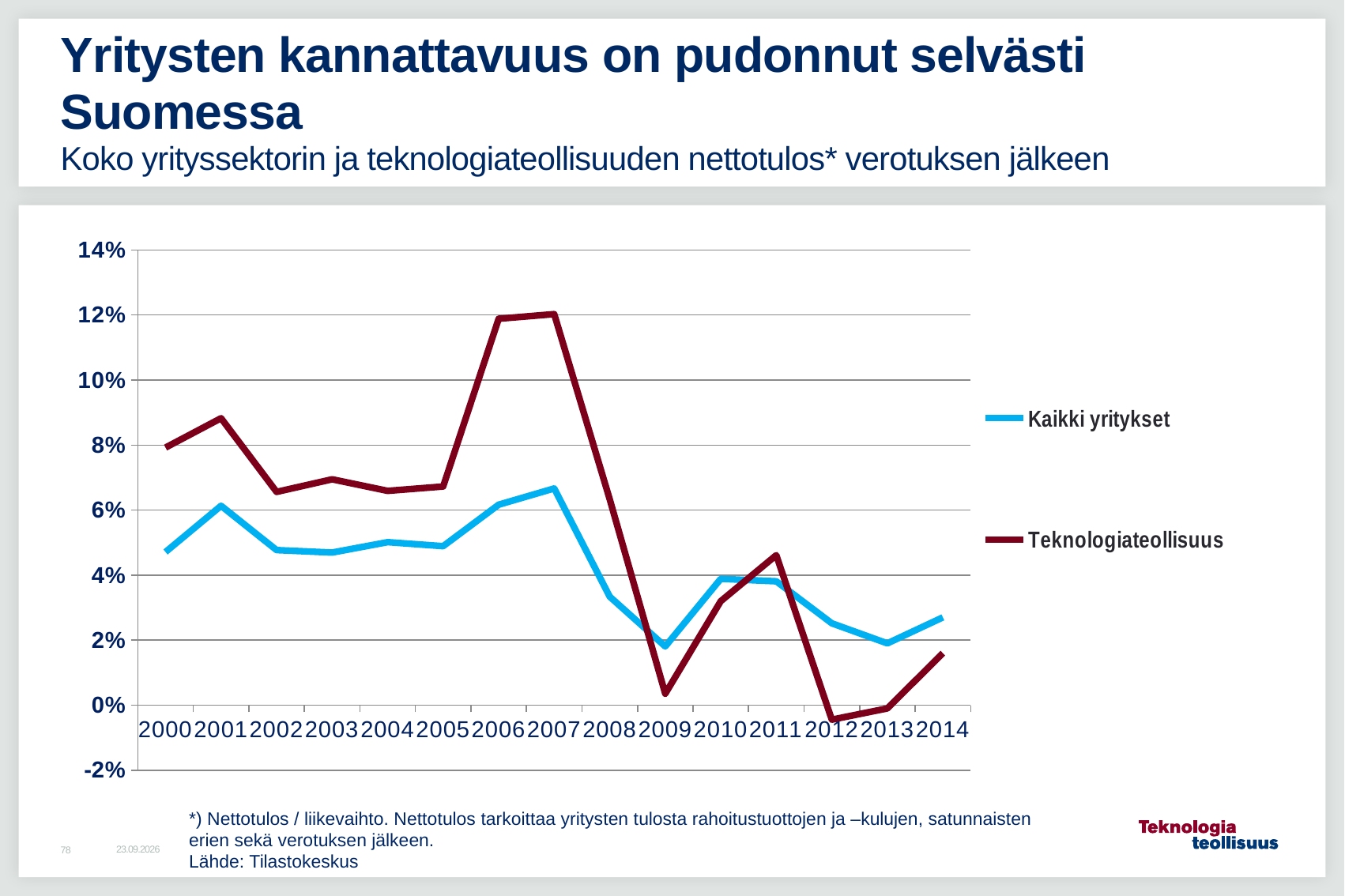
Is the value for Kaikki yritykset in 2000 greater or less than 4%? greater Is the value for Teknologiateollisuus in 2009 greater or less than 2%? less How many years are shown on the x axis? 15 In which year does the Kaikki yritykset line reach its highest value? 2007 Does the Teknologiateollisuus line rise or fall from 2007 to 2009? Fall In 2009, which series has the higher value, Kaikki yritykset or Teknologiateollisuus? Kaikki yritykset In 2007, which series has the higher value, Kaikki yritykset or Teknologiateollisuus? Teknologiateollisuus Is the value for Teknologiateollisuus in 2012 greater or less than 0%? less What colour is the Kaikki yritykset line? Blue How many series does the legend list? 2 What kind of chart is shown on the slide? Line chart